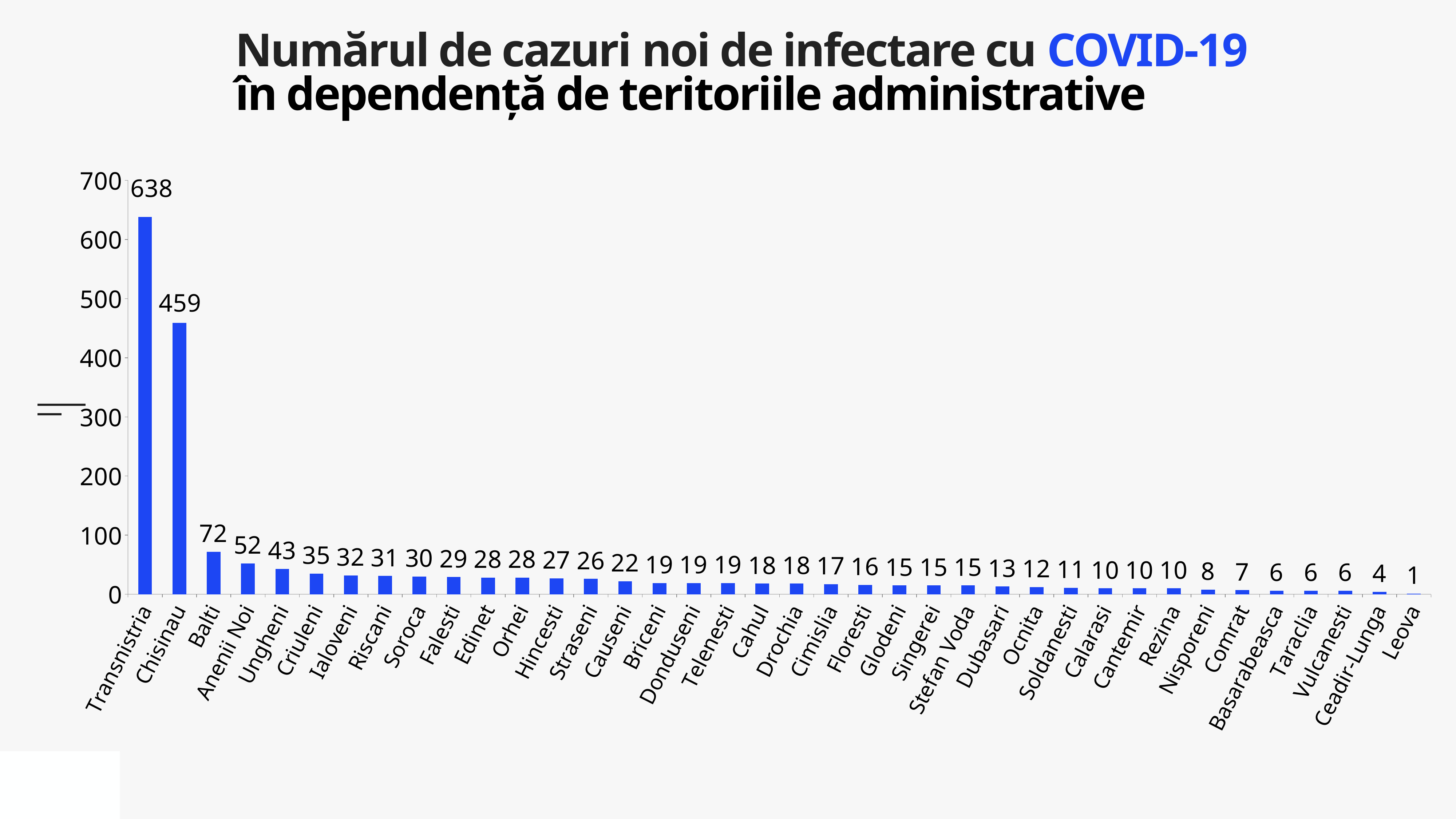
What is the value for Ungheni? 43 Which territory has the highest number of new cases? Transnistria What is the value for Chisinau? 459 Which territory has the lowest number of new cases? Leova What is the value for Balti? 72 Is the value for Chisinau greater or less than 400? greater What kind of chart is shown on the slide? bar chart Which is larger, the value for Anenii Noi or the value for Criuleni? Anenii Noi What is the value for Transnistria? 638 What is the difference between the values for Transnistria and Chisinau? 179 Do the values rise or fall from left to right along the x axis? fall How many territories are shown on the chart? 38